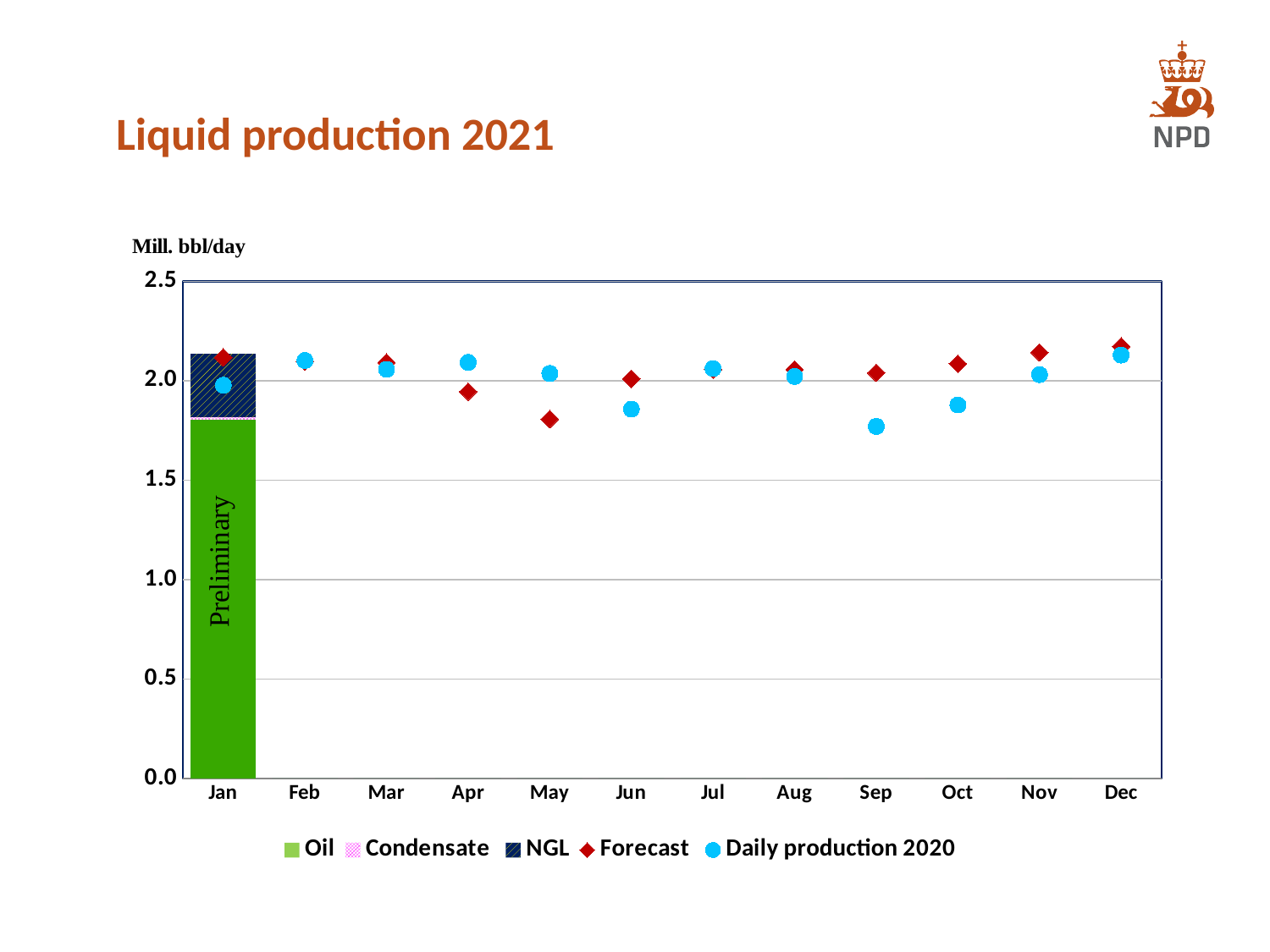
How many series does the legend list? 5 In which month is the Daily production 2020 value lowest? Sep Is the Forecast value for May greater or less than 2.0? less In which month is the Forecast value lowest? May What kind of chart is shown on the slide? A bar chart combined with scatter markers How many months are shown along the x axis? 12 In May, which is larger: the Forecast value or the Daily production 2020 value? Daily production 2020 Is the Daily production 2020 value for Sep greater or less than 2.0? less What unit is shown on the y axis? Mill. bbl/day Is the Oil portion of the Jan bar greater or less than 2.0? less What is the title of the chart? Liquid production 2021